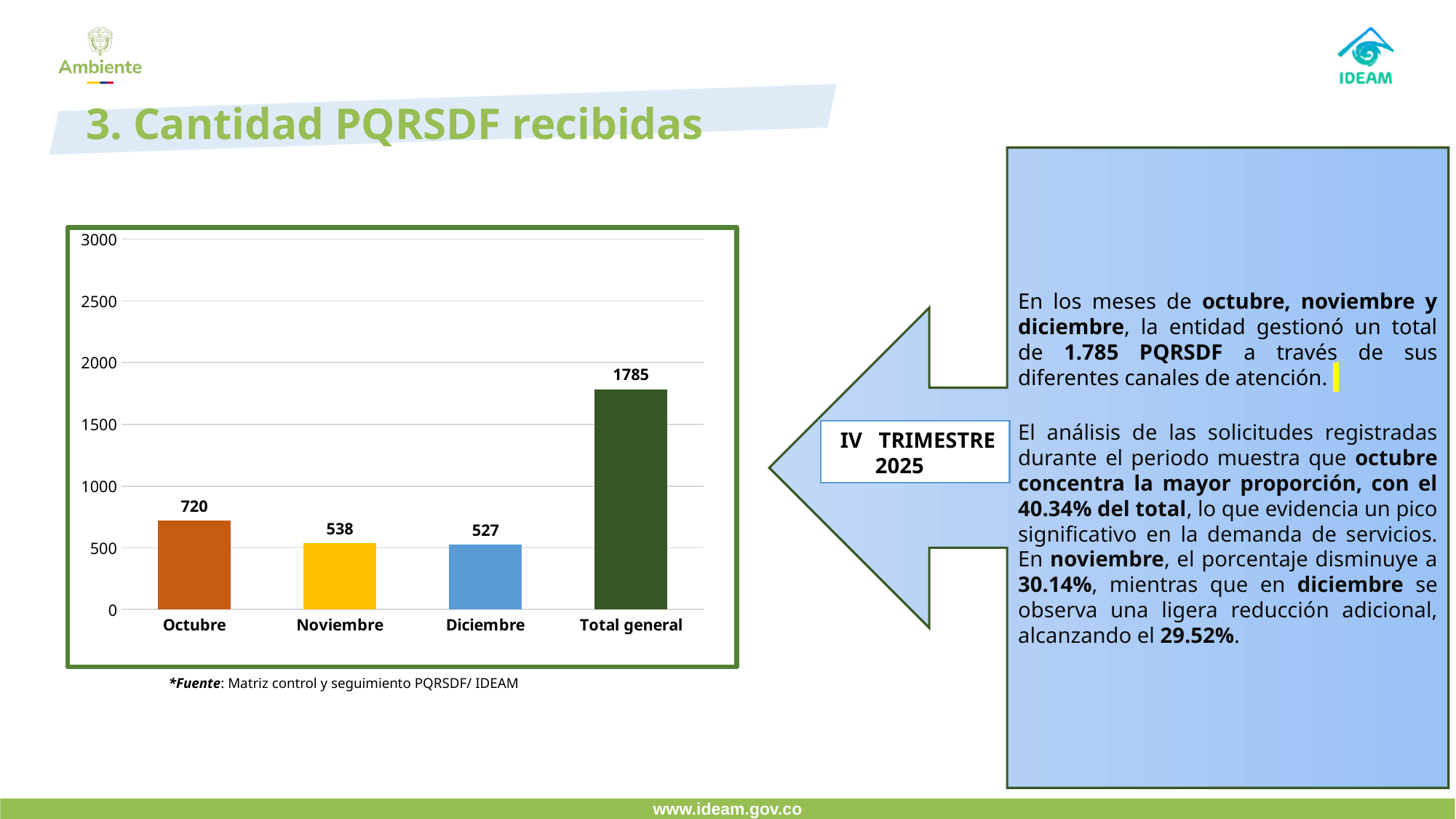
What is the value for Noviembre? 538 Is the value for Total general greater or less than 1500? greater Which of the three months (Octubre, Noviembre, Diciembre) has the highest value? Octubre What colour is the bar for Noviembre? yellow What is the value for Diciembre? 527 What is the value for Octubre? 720 What kind of chart is shown on the slide? bar chart What is the difference between the values for Octubre and Noviembre? 182 Which is larger, the value for Octubre or the value for Diciembre? Octubre Which category has the lowest value? Diciembre How many categories are shown on the x axis? 4 What is the value for Total general? 1785